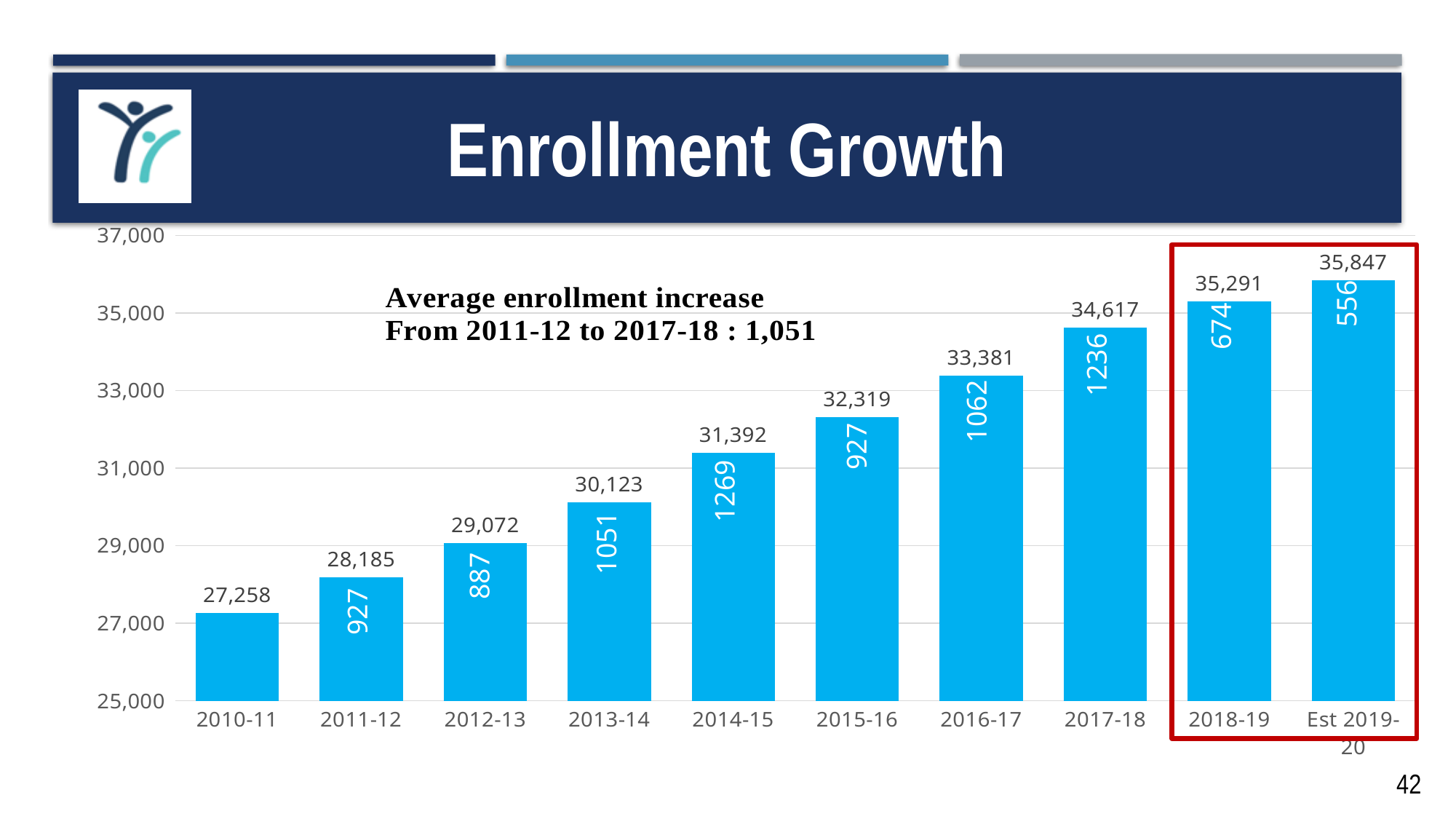
What is the enrollment value for 2015-16? 32,319 Do enrollment values rise or fall from 2010-11 to Est 2019-20? rise How many years (bars) are shown on the chart? 10 Which is larger, the enrollment for 2013-14 or 2012-13? 2013-14 What kind of chart is shown on the slide? bar chart Which year has the highest enrollment? Est 2019-20 What is the estimated enrollment for Est 2019-20? 35,847 Is the enrollment value for 2011-12 greater or less than 29,000? less What is the enrollment value for 2010-11? 27,258 Which year has the lowest enrollment? 2010-11 What is the year-over-year increase printed inside the 2014-15 bar? 1269 What is the difference in enrollment between 2017-18 and 2016-17? 1,236